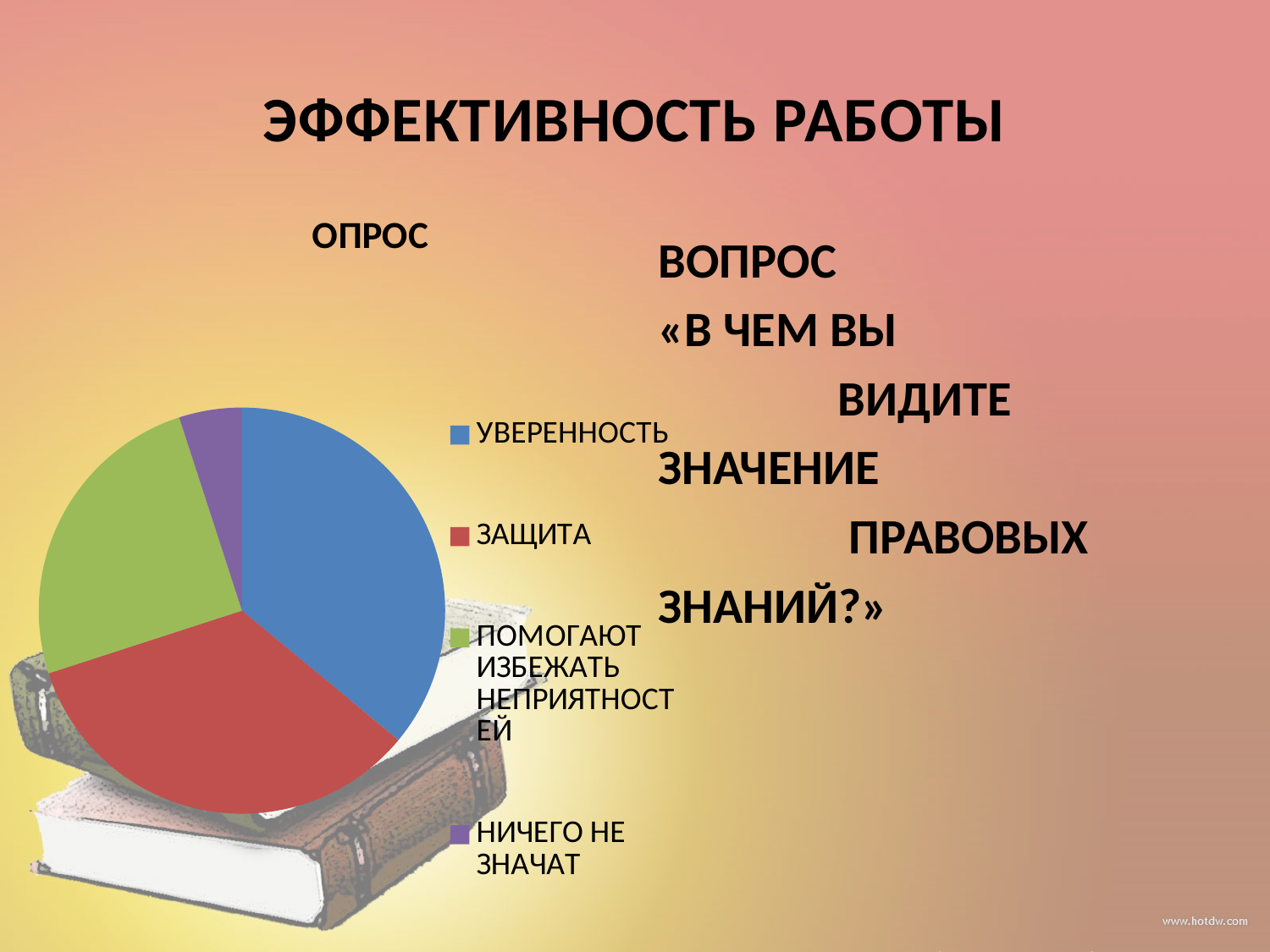
Which slice is larger, УВЕРЕННОСТЬ or ПОМОГАЮТ ИЗБЕЖАТЬ НЕПРИЯТНОСТЕЙ? УВЕРЕННОСТЬ Which category has the smallest slice in the pie chart? НИЧЕГО НЕ ЗНАЧАТ Which category has the largest slice in the pie chart? УВЕРЕННОСТЬ Which slice is larger, ЗАЩИТА or НИЧЕГО НЕ ЗНАЧАТ? ЗАЩИТА What is the title of the pie chart? ОПРОС What colour is the ЗАЩИТА slice in the pie chart? red How many entries does the legend of the pie chart list? 4 Which slice is larger, ПОМОГАЮТ ИЗБЕЖАТЬ НЕПРИЯТНОСТЕЙ or НИЧЕГО НЕ ЗНАЧАТ? ПОМОГАЮТ ИЗБЕЖАТЬ НЕПРИЯТНОСТЕЙ What kind of chart is shown on the slide? pie chart How many slices does the pie chart have? 4